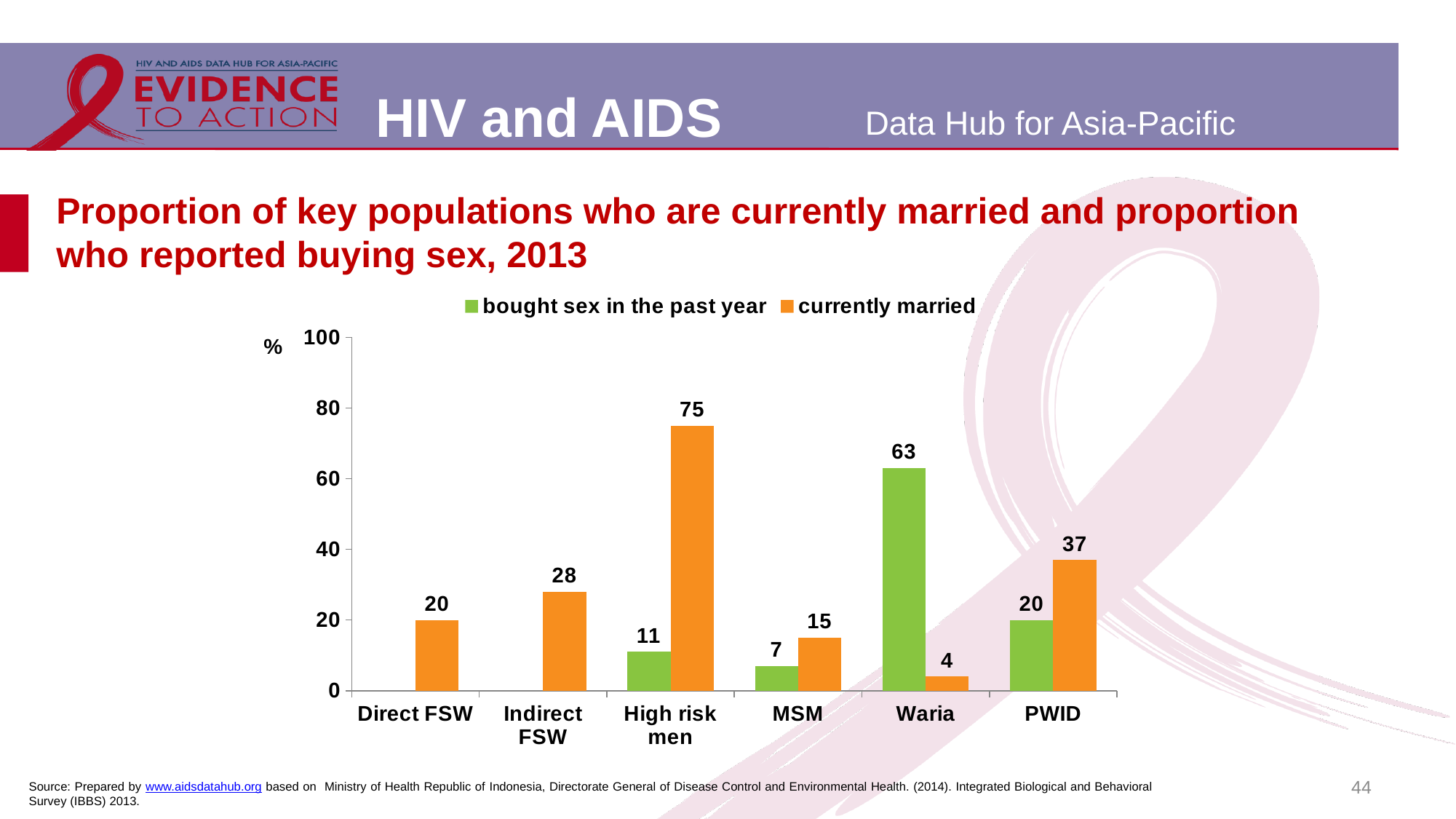
What is the value for 'currently married' for Indirect FSW? 28 What is the difference between the 'currently married' and 'bought sex in the past year' values for PWID? 17 How many series does the legend list? 2 Which category has the highest value for 'currently married'? High risk men What is the value for 'bought sex in the past year' for Waria? 63 Which is larger for Waria: 'bought sex in the past year' or 'currently married'? bought sex in the past year How many categories are shown on the x axis? 6 What is the value for 'bought sex in the past year' for MSM? 7 Which category has the lowest value for 'currently married'? Waria What is the value for 'currently married' for High risk men? 75 Which colour represents 'currently married' in the chart? orange What kind of chart is shown on the slide? bar chart